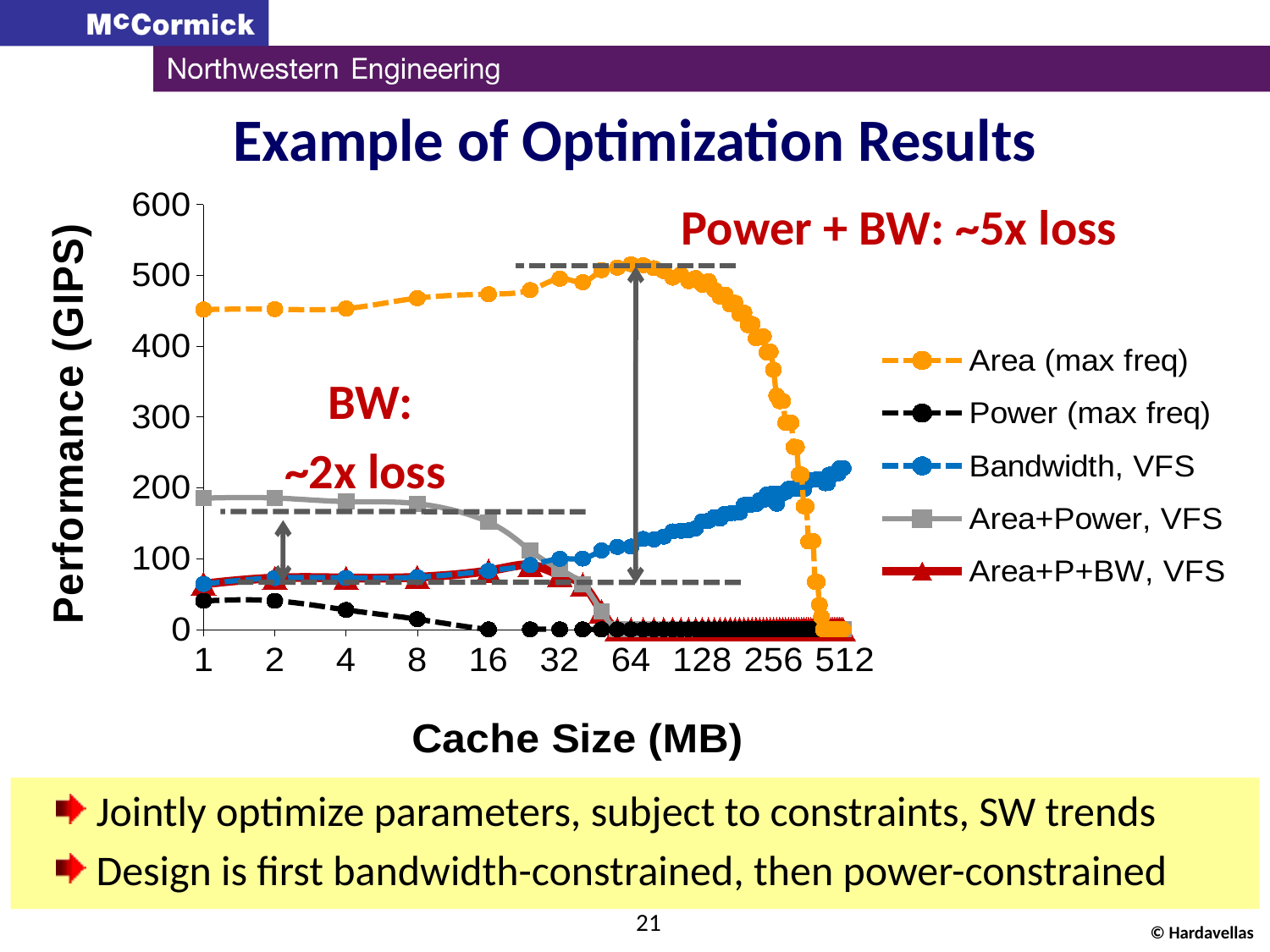
What is the title of the chart on the slide? Example of Optimization Results What kind of chart is shown on the slide? line chart Does the Bandwidth, VFS series rise or fall as cache size increases? rise Is the value for Area+Power, VFS at cache size 1 MB greater or less than 100? greater Is the value for Bandwidth, VFS at cache size 512 MB greater or less than 200? greater Is the value for Power (max freq) at cache size 1 MB greater or less than 100? less How many cache size tick labels are shown on the x axis? 10 What is the label of the y axis? Performance (GIPS) At cache size 512 MB, which is larger: Bandwidth, VFS or Area (max freq)? Bandwidth, VFS Which series has the highest performance at cache size 1 MB? Area (max freq) How many series does the legend list? 5